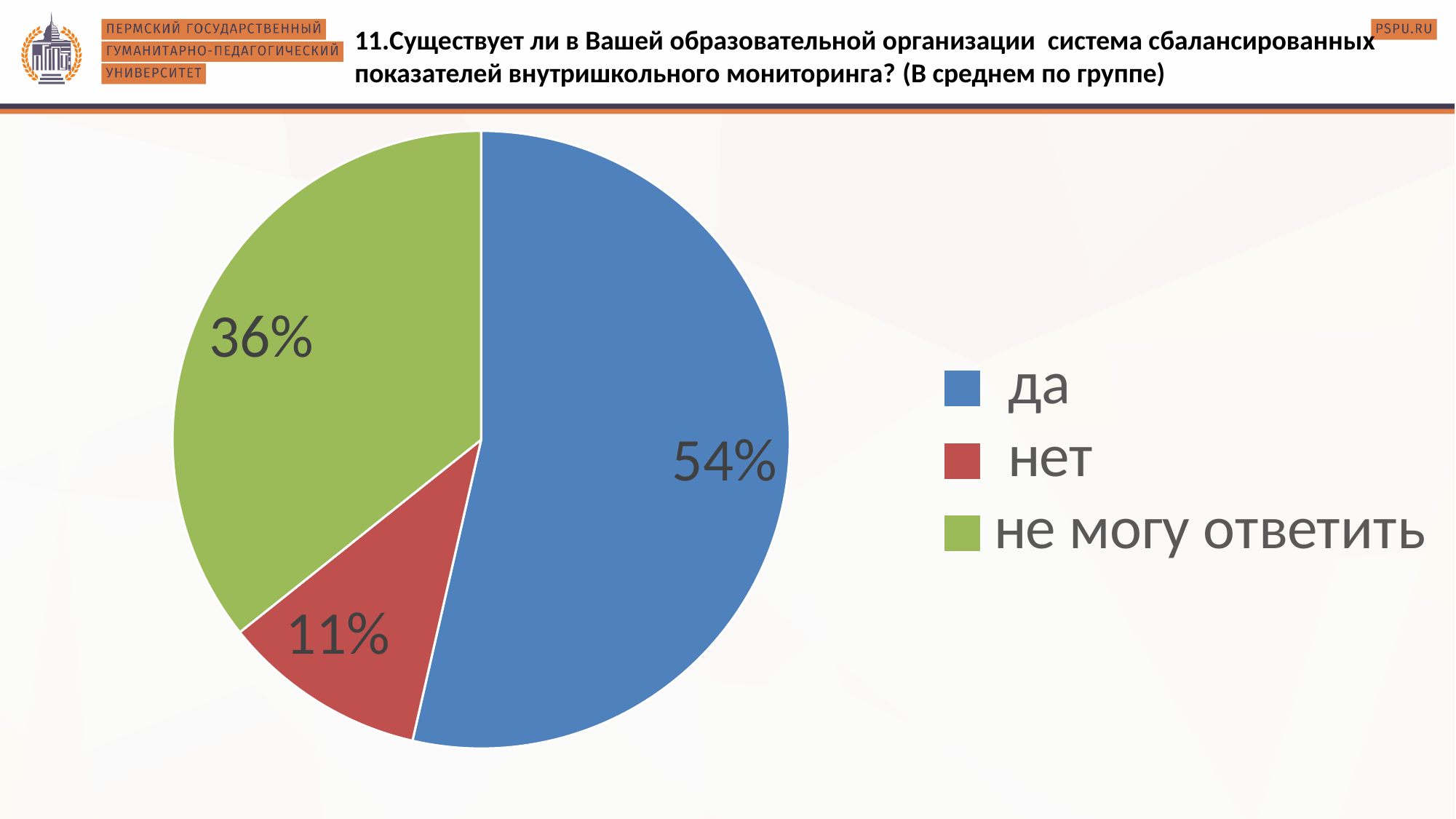
How many entries does the legend list? 3 What percentage of respondents answered "нет"? 11% What percentage of respondents answered "не могу ответить"? 36% What is the difference in percentage points between "не могу ответить" and "нет"? 25 What is the difference in percentage points between "да" and "не могу ответить"? 18 What type of chart is shown on the slide? pie chart Which answer option has the largest share of the pie? да Which is larger: the share for "нет" or the share for "не могу ответить"? не могу ответить How many slices does the pie chart have? 3 Which answer option has the smallest share of the pie? нет What percentage of respondents answered "да"? 54% What colour is the slice for "не могу ответить"? green